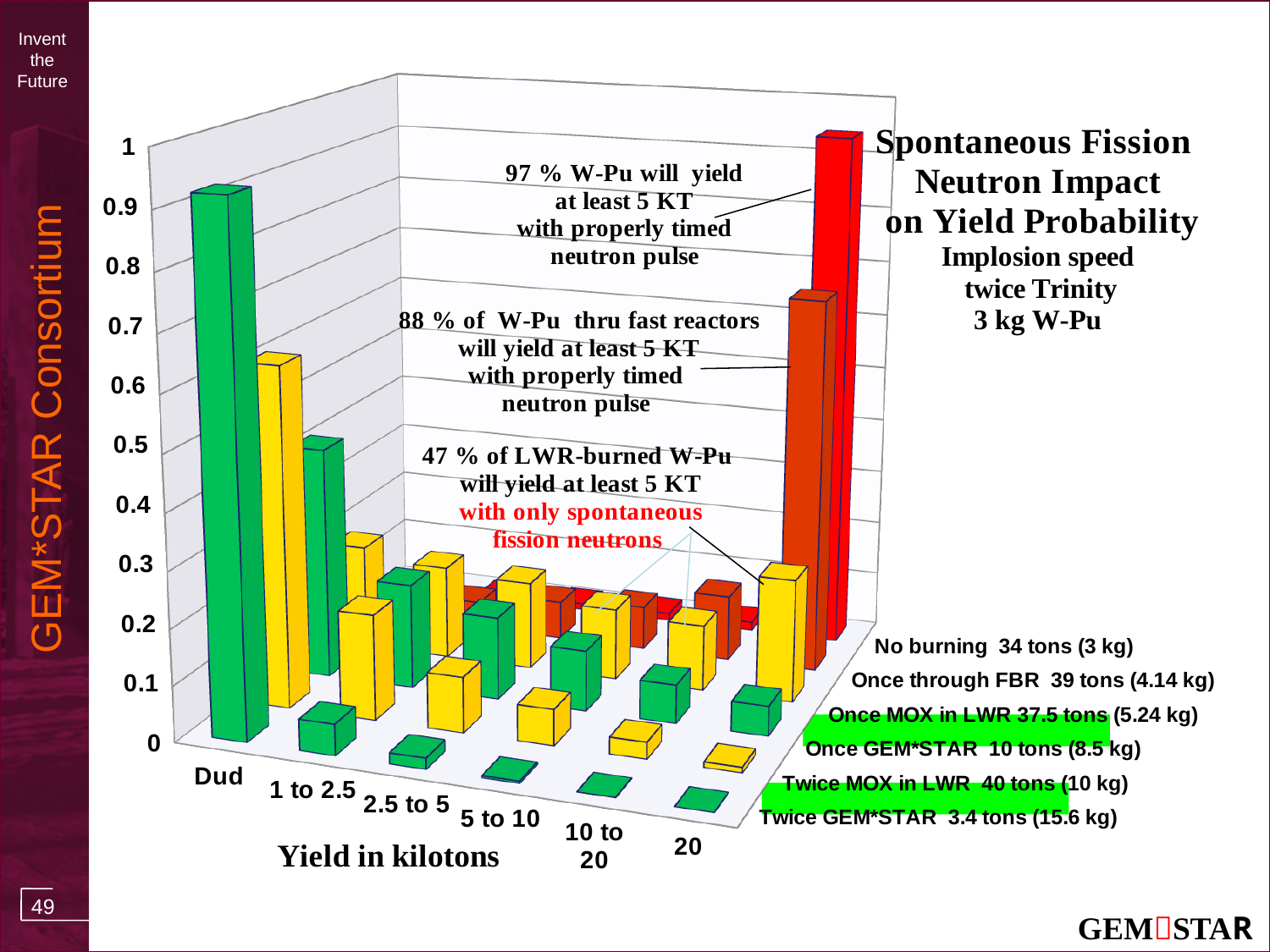
How many series (fuel burning cases) are listed on the chart? 6 Is the value for 1 to 2.5 kilotons in the Twice GEM*STAR 3.4 tons (15.6 kg) series greater or less than 0.3? less What is the title of the chart? Spontaneous Fission Neutron Impact on Yield Probability What kind of chart is shown on the slide? bar chart What is the label of the x axis? Yield in kilotons In the Twice GEM*STAR 3.4 tons (15.6 kg) series, which yield category has the highest value? Dud How many yield categories are shown along the x axis? 6 Is the value for Dud in the Twice GEM*STAR 3.4 tons (15.6 kg) series greater or less than 0.8? greater Which series has the tallest bar at 20 kilotons? No burning 34 tons (3 kg) Is the value for 20 kilotons in the Twice GEM*STAR 3.4 tons (15.6 kg) series greater or less than 0.1? less In the Twice GEM*STAR 3.4 tons (15.6 kg) series, which is larger: the value for Dud or the value for 20 kilotons? Dud Which series has the tallest bar in the Dud category? Twice GEM*STAR 3.4 tons (15.6 kg)